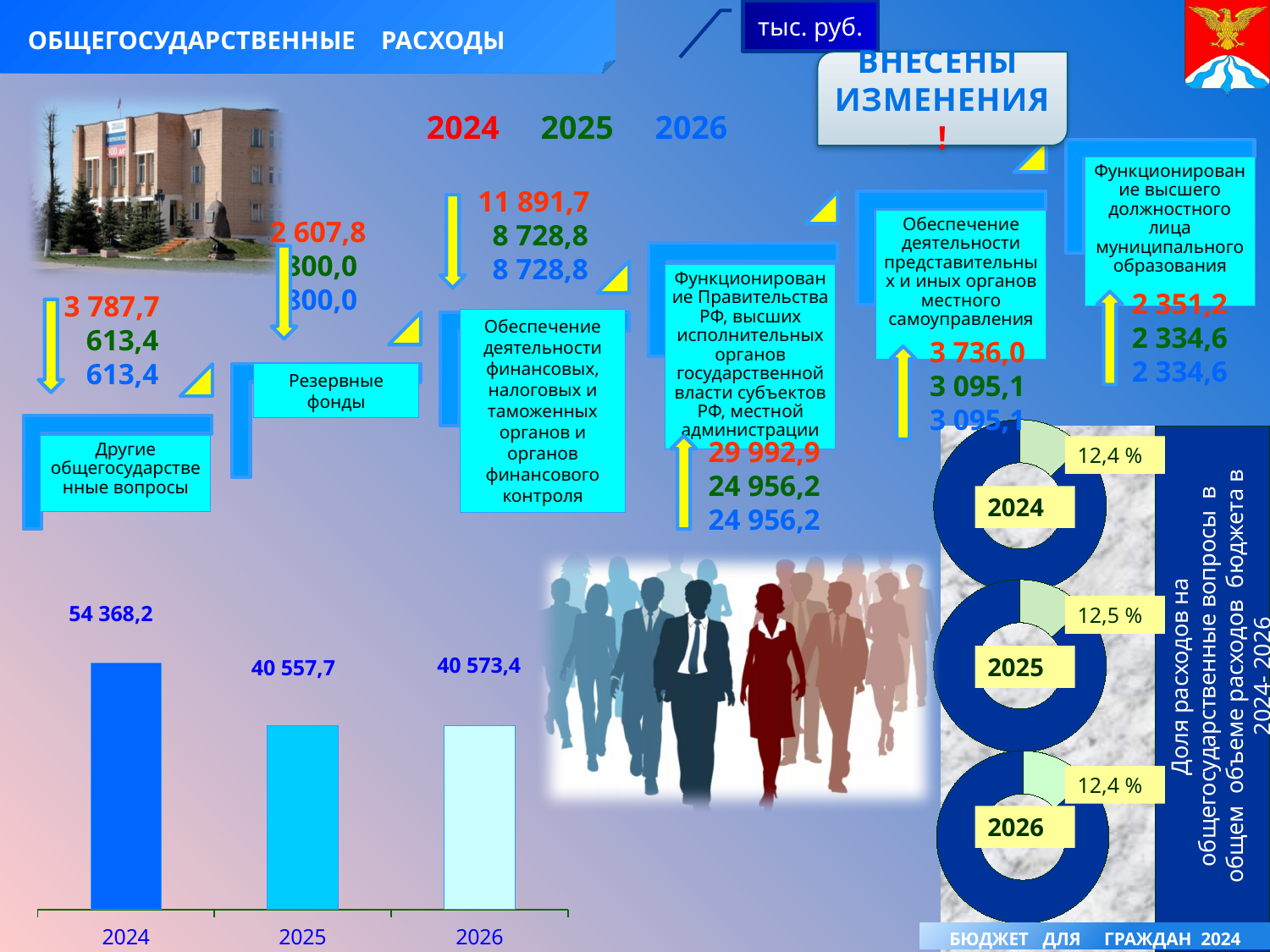
In the bar chart at the bottom left, what is the value for 2026? 40 573,4 In the bar chart at the bottom left, which year has the highest value? 2024 In the donut charts on the right (share of expenditures on general state issues), what is the share shown for 2025? 12,5 % In the bar chart at the bottom left, does the value rise or fall from 2024 to 2025? fall How many donut charts are shown on the right side of the slide? 3 In the bar chart at the bottom left, what is the difference between the values for 2026 and 2025? 15,7 In the bar chart at the bottom left, how many bars are plotted? 3 In the donut charts on the right (share of expenditures on general state issues), what is the share shown for 2024? 12,4 % In the bar chart at the bottom left, what is the value for 2024? 54 368,2 What type of chart is shown at the bottom left of the slide? bar chart In the bar chart at the bottom left, what is the difference between the values for 2024 and 2025? 13 810,5 In the bar chart at the bottom left, what is the value for 2025? 40 557,7